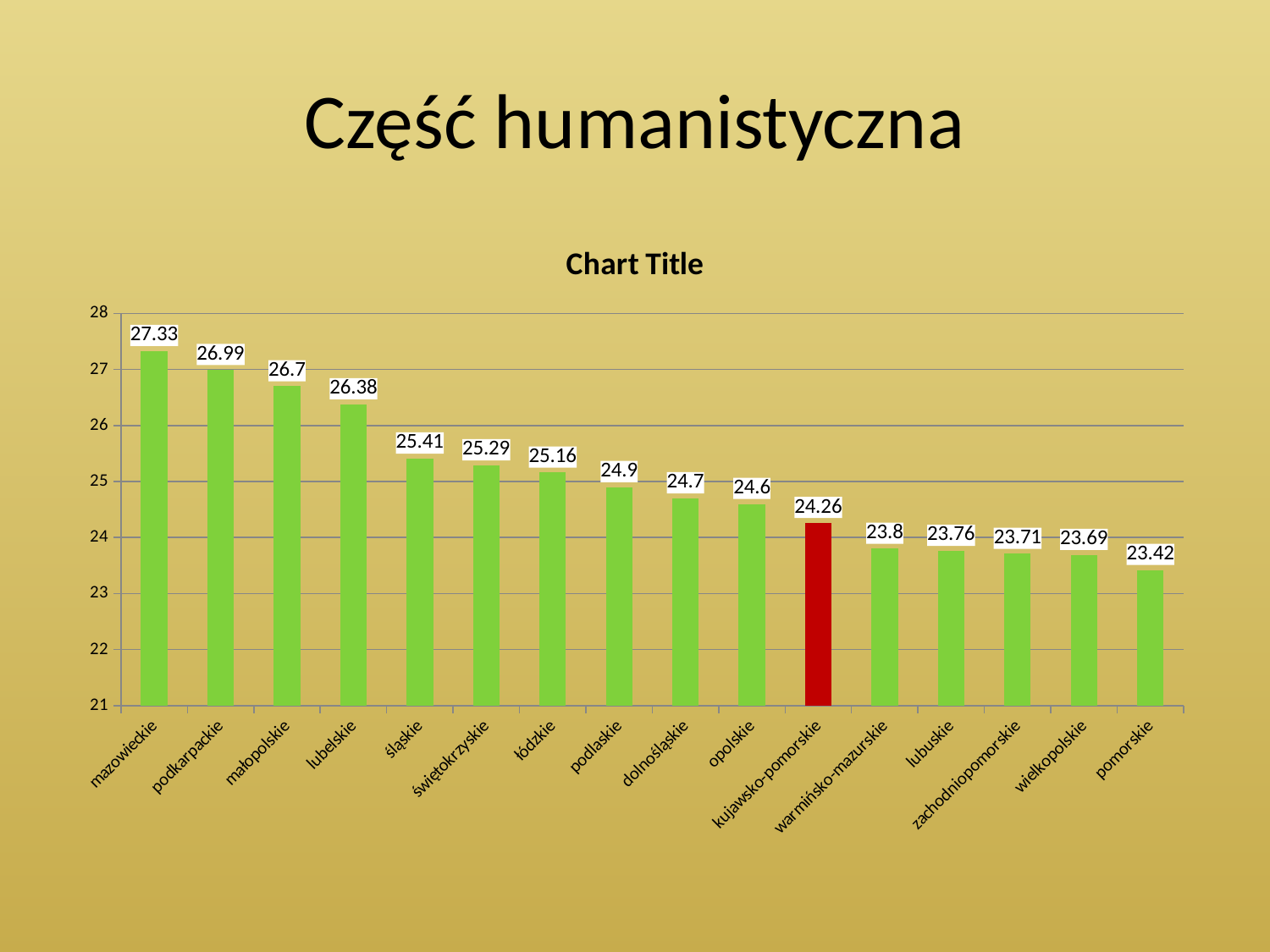
Which is larger, the value for lubelskie or the value for śląskie? lubelskie Which category has the lowest value? pomorskie Which category's bar is coloured red instead of green? kujawsko-pomorskie What kind of chart is shown on the slide? bar chart How many categories are shown on the x axis? 16 What is the value for pomorskie? 23.42 What is the value for kujawsko-pomorskie? 24.26 Is the value for opolskie greater or less than 24? greater Do the values rise or fall from left to right along the x axis? fall Which category has the highest value? mazowieckie What is the difference between the values for mazowieckie and pomorskie? 3.91 What is the value for mazowieckie? 27.33